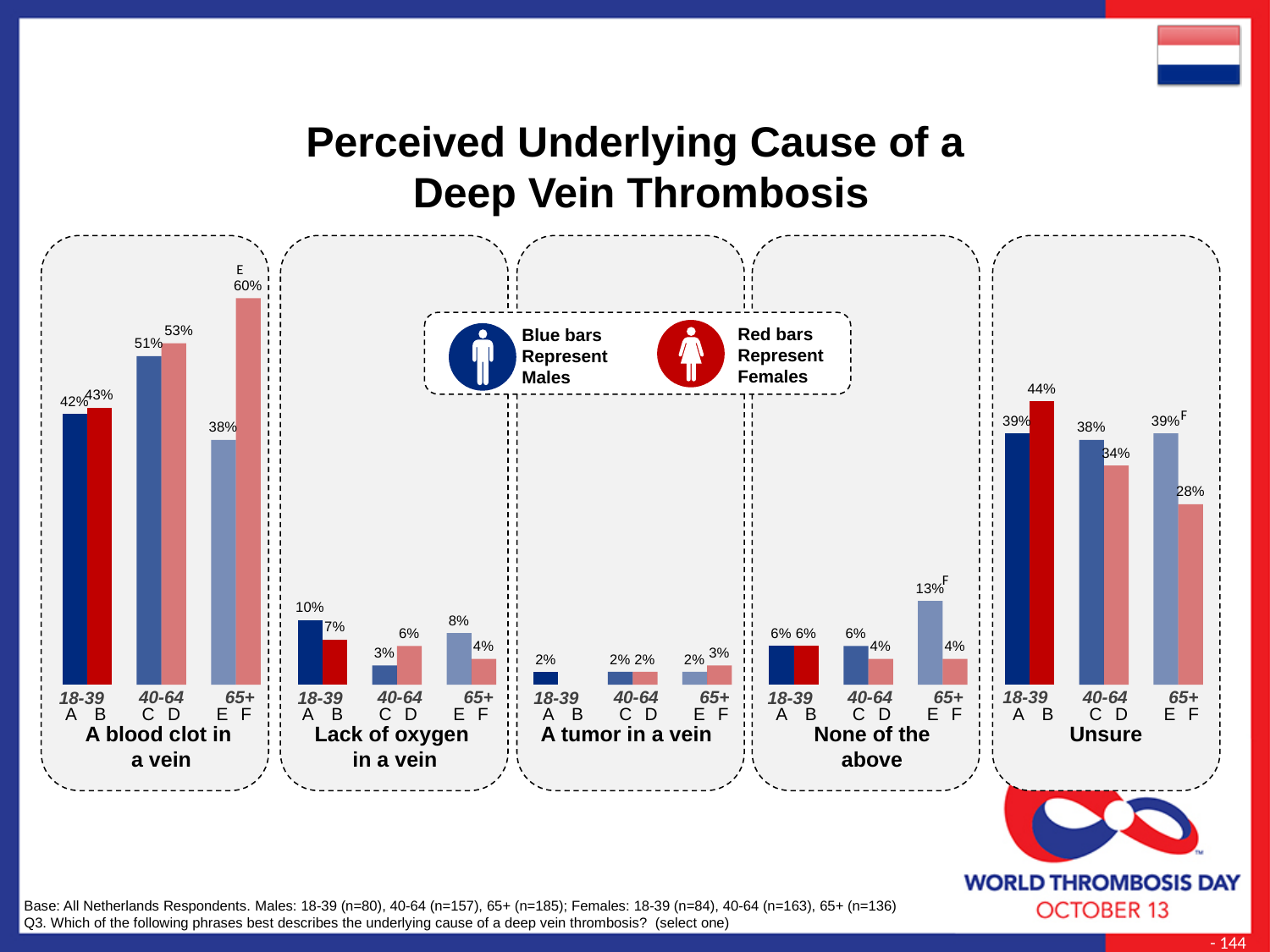
In the 'A blood clot in a vein' panel, what is the difference between females aged 65+ and males aged 65+? 22 percentage points In the 'None of the above' panel, which group has the highest value? Males 65+ (13%) In the 'Unsure' panel, which is larger: males aged 65+ or females aged 65+? Males aged 65+ (39%) What type of chart is used on this slide? Bar chart In the 'Unsure' panel, what is the difference between males aged 40-64 and females aged 40-64? 4 percentage points In the 'A blood clot in a vein' panel, which group has the lowest value? Males 65+ (38%) In the 'Lack of oxygen in a vein' panel, what is the value for males aged 18-39? 10% How many answer categories (panels) are shown on the slide? 5 In the 'A blood clot in a vein' panel, what is the value for males aged 40-64? 51% In the 'Unsure' panel, what is the value for females aged 18-39? 44% In the 'A blood clot in a vein' panel, what percentage of females aged 65+ chose this answer? 60% According to the legend, what do the red bars represent? Females